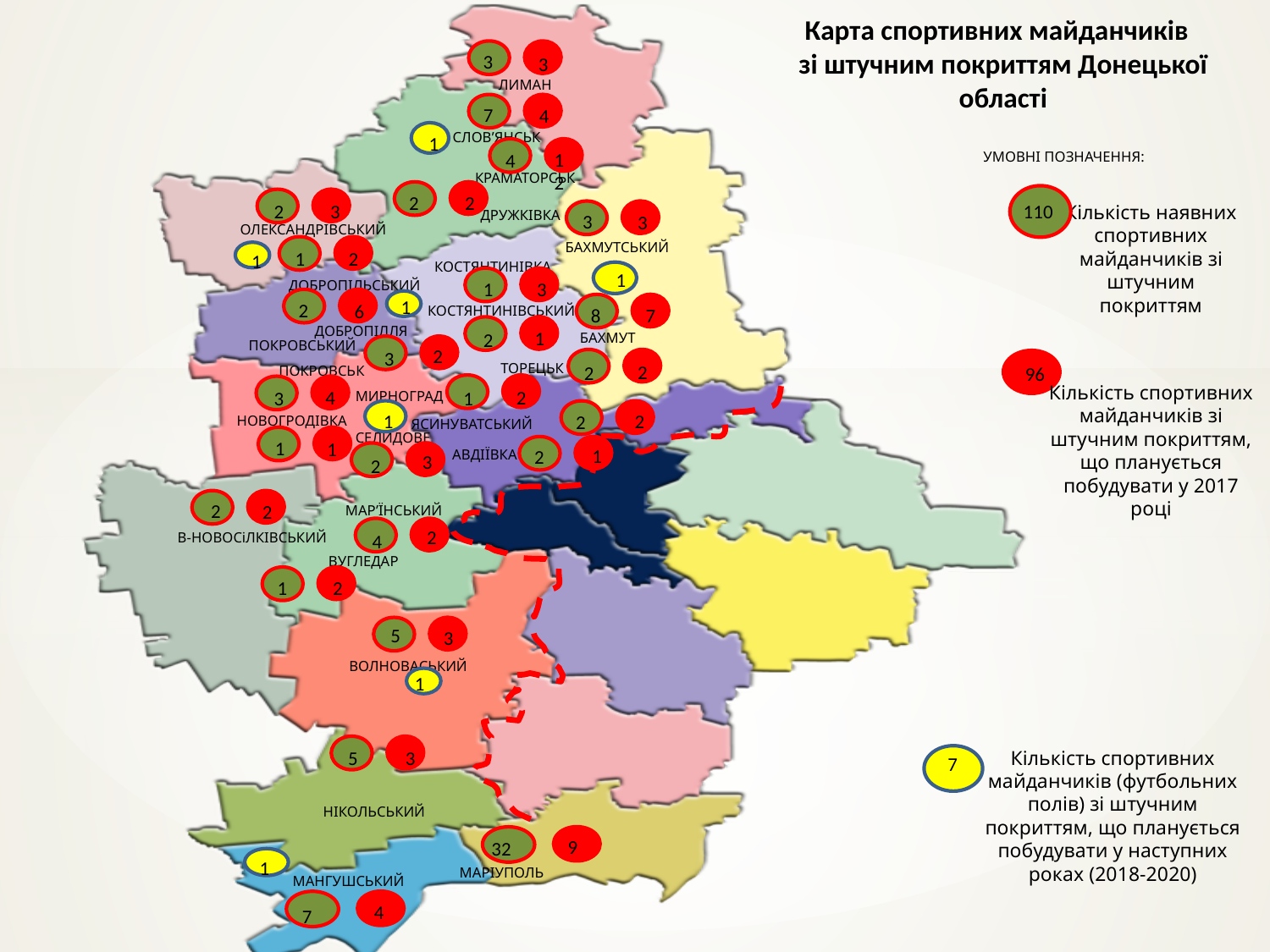
How many sports grounds planned for 2017 (red marker) are shown for Маріуполь? 9 What kind of visualization is shown on the slide? A map with numbered markers What is the title of the map on the slide? Карта спортивних майданчиків зі штучним покриттям Донецької області According to the legend, what is the total number of existing sports grounds with artificial surface (green marker)? 110 What is the difference between the green and red marker values for Маріуполь? 23 According to the legend, how many football fields with artificial surface are planned for 2018-2020 (yellow marker)? 7 According to the legend, how many sports grounds with artificial surface are planned to be built in 2017 (red marker)? 96 How many existing sports grounds (green marker) are shown for Бахмут? 8 How many marker types does the legend (УМОВНІ ПОЗНАЧЕННЯ) list? 3 How many existing sports grounds (green marker) are shown for Маріуполь? 32 Which has more existing sports grounds (green marker): Бахмут or Мангушський? Бахмут Which location has the highest number of existing sports grounds (green marker)? Маріуполь